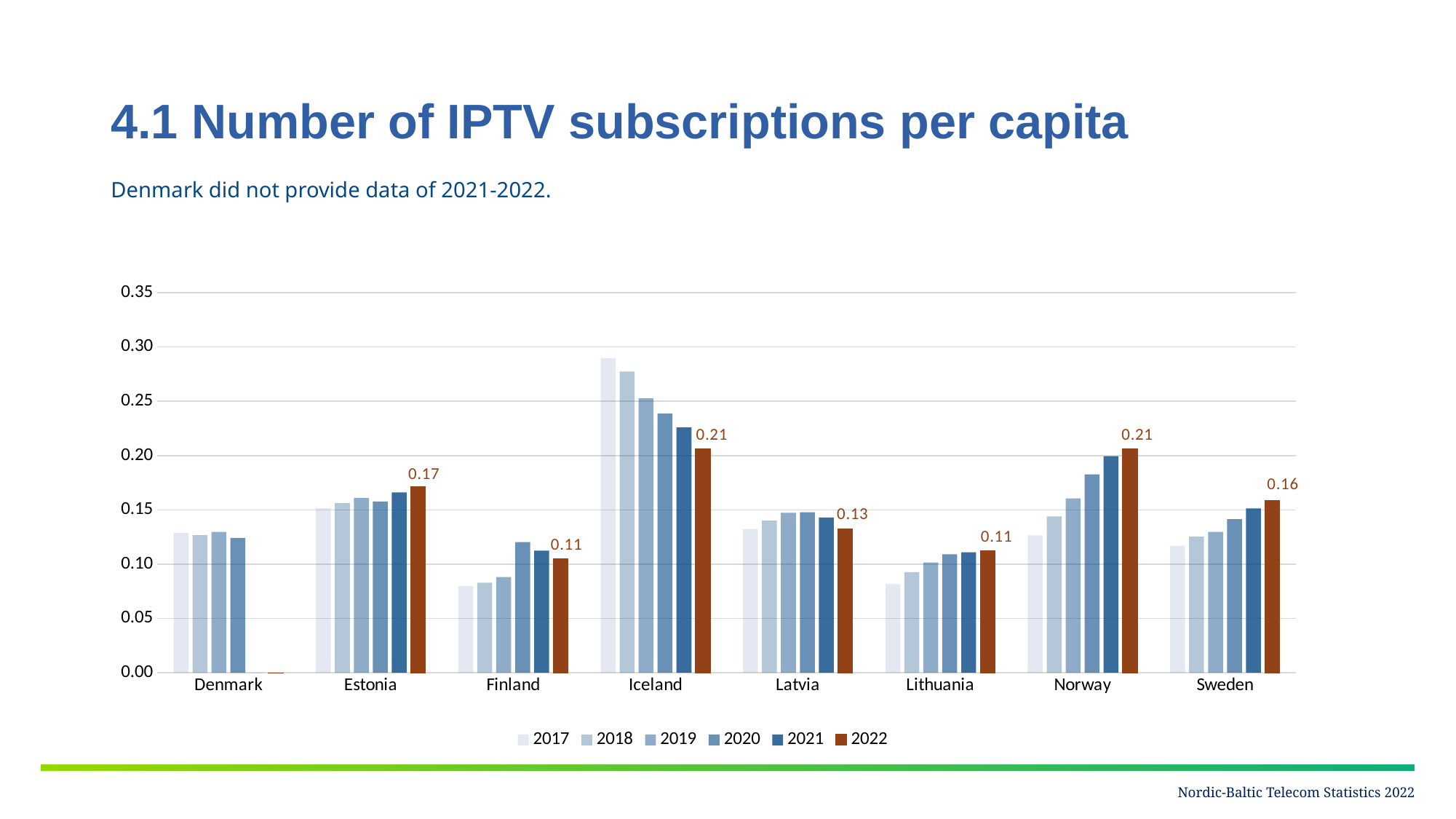
Is the value for Denmark in 2017 greater or less than 0.15? less Which is larger, the 2022 value for Estonia or the 2022 value for Latvia? Estonia What is the value for Estonia in 2022? 0.17 What is the difference between the 2022 values for Iceland and Latvia? 0.08 Is the value for Iceland in 2017 greater or less than 0.25? greater How many series does the legend list? 6 What is the value for Latvia in 2022? 0.13 How many countries are shown on the x axis? 8 Which country has the tallest bar in the chart? Iceland What is the value for Sweden in 2022? 0.16 What is the value for Finland in 2022? 0.11 Do the values for Norway rise or fall from 2017 to 2022? rise